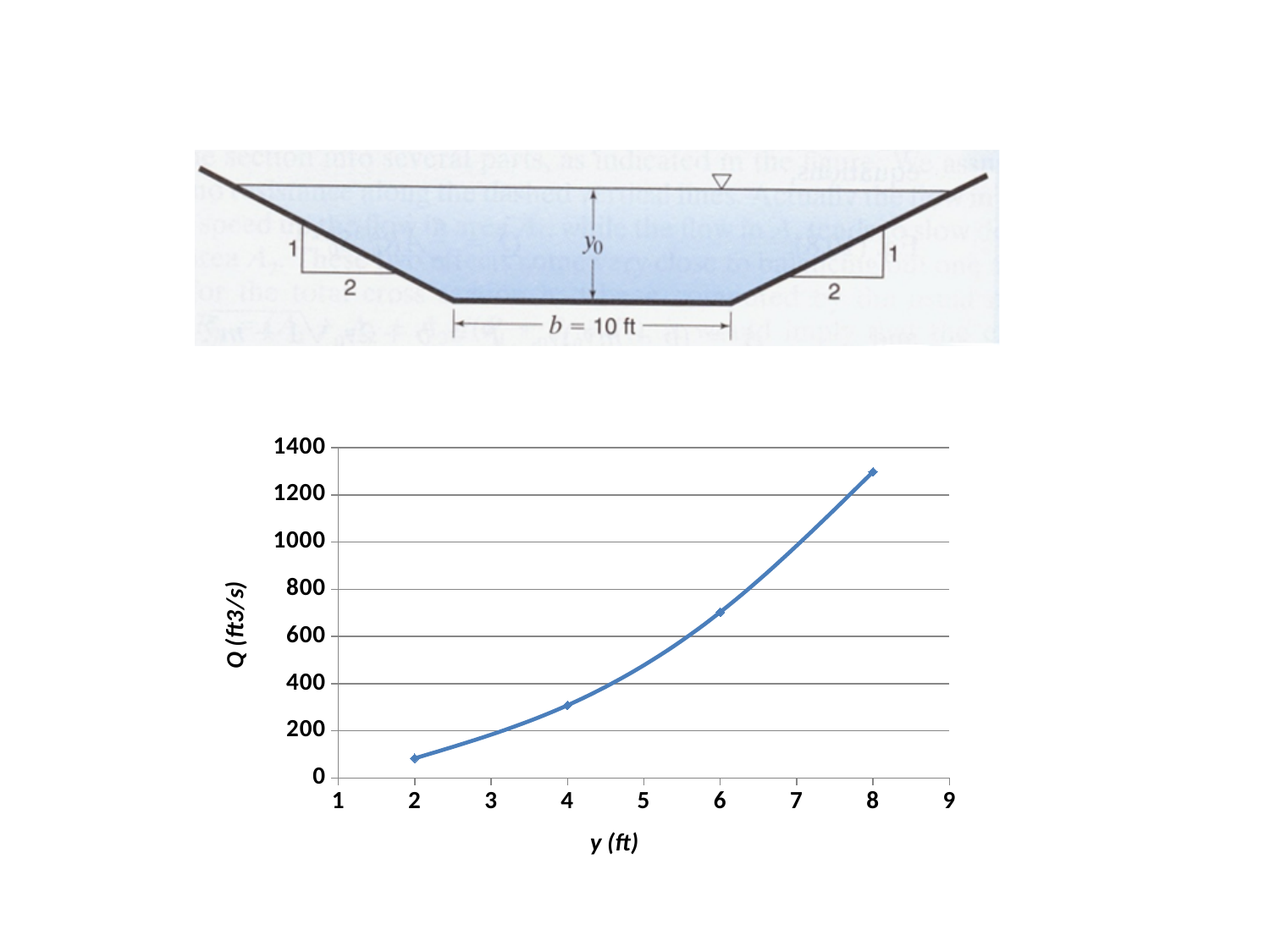
How many data points are plotted on the chart? 4 Does Q rise or fall as y increases along the x axis? rise At which value of y is Q lowest? 2 What kind of chart is shown on the slide? line chart Is the value of Q at y = 2 ft greater or less than 200? less Which is larger, Q at y = 4 ft or Q at y = 6 ft? Q at y = 6 ft Is the value of Q at y = 4 ft greater or less than 400? less Is the value of Q at y = 8 ft greater or less than 1200? greater What is the label of the vertical axis of the chart? Q (ft3/s) What is the label of the horizontal axis of the chart? y (ft) At which value of y is Q highest? 8